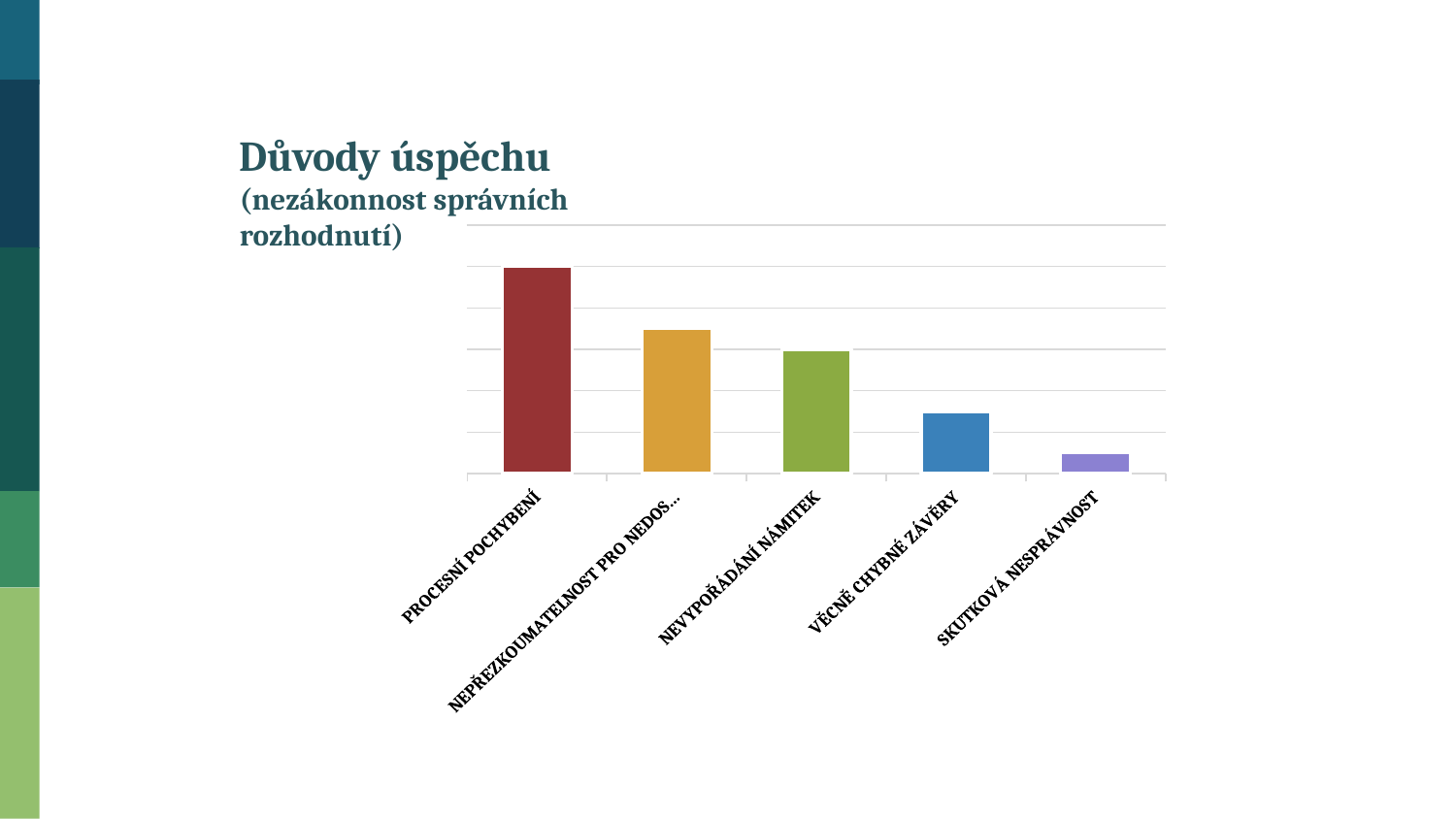
Which is larger, the value for PROCESNÍ POCHYBENÍ or the value for SKUTKOVÁ NESPRÁVNOST? PROCESNÍ POCHYBENÍ Which category has the highest value in the chart? PROCESNÍ POCHYBENÍ What colour is the bar for PROCESNÍ POCHYBENÍ? dark red What is the title of the slide containing the chart? Důvody úspěchu (nezákonnost správních rozhodnutí) Which is larger, the value of the second bar (NEPŘEZKOUMATELNOST PRO NEDOS...) or the value for NEVYPOŘÁDÁNÍ NÁMITEK? the second bar (NEPŘEZKOUMATELNOST PRO NEDOS...) Which is larger, the value for VĚCNĚ CHYBNÉ ZÁVĚRY or the value for SKUTKOVÁ NESPRÁVNOST? VĚCNĚ CHYBNÉ ZÁVĚRY How many categories (bars) does the chart show? 5 Do the bar values rise or fall from left to right along the x axis? fall Which category has the lowest value in the chart? SKUTKOVÁ NESPRÁVNOST What kind of chart is shown on the slide? bar chart